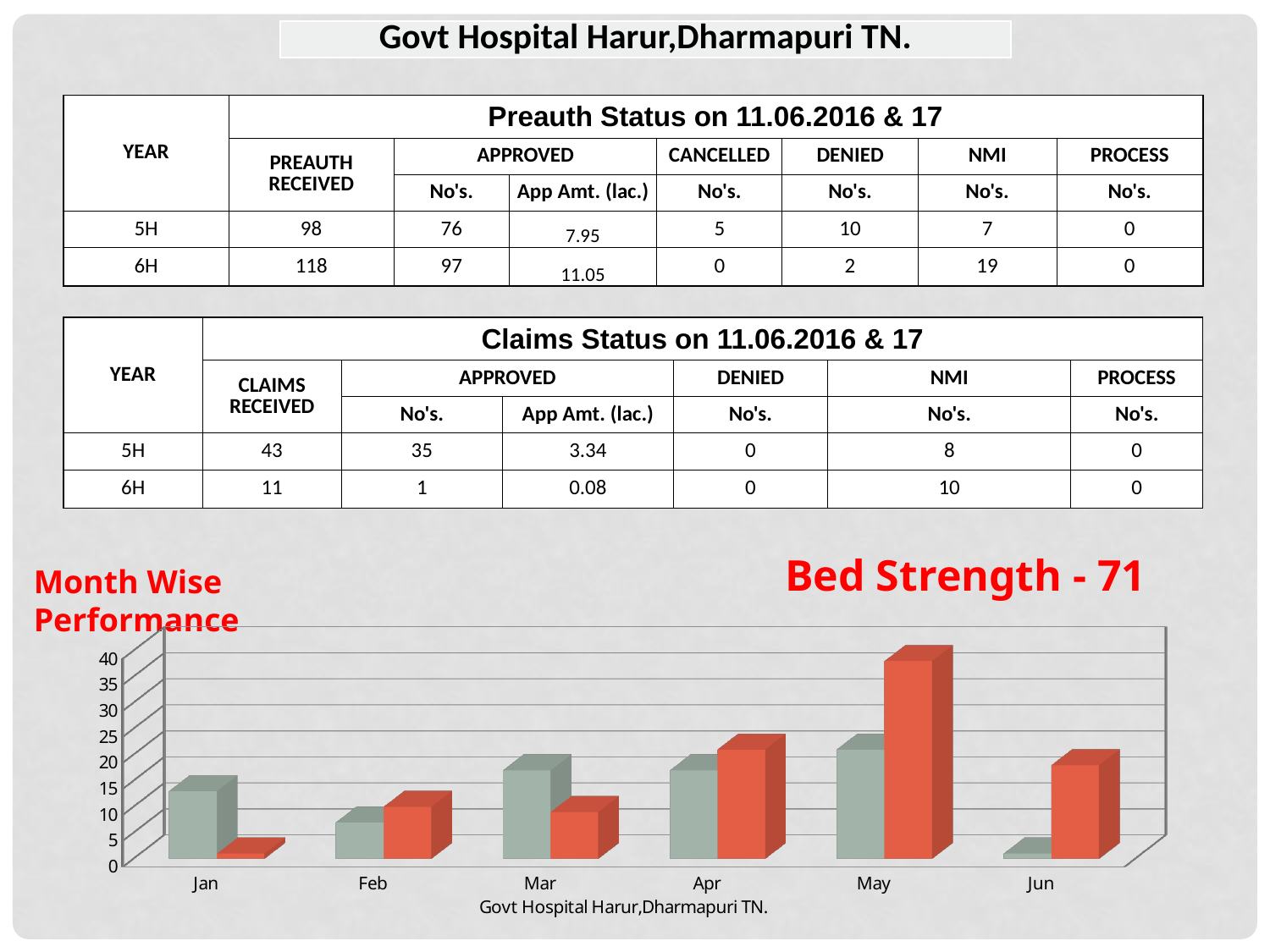
In the bar chart, which month has the shortest red bar? Jan Is the red bar for May greater or less than 35? greater In the bar chart, which is taller for Jun: the grey bar or the red bar? the red bar What kind of chart is shown at the bottom of the slide? bar chart In the bar chart, which month has the shortest grey bar? Jun In the bar chart, which is taller for Mar: the grey bar or the red bar? the grey bar Is the grey bar for Jan greater or less than 10? greater What text appears below the x axis of the bar chart? Govt Hospital Harur,Dharmapuri TN. Is the grey bar for Feb greater or less than 10? less In the bar chart, which month has the tallest red bar? May How many months are shown on the x axis of the bar chart? 6